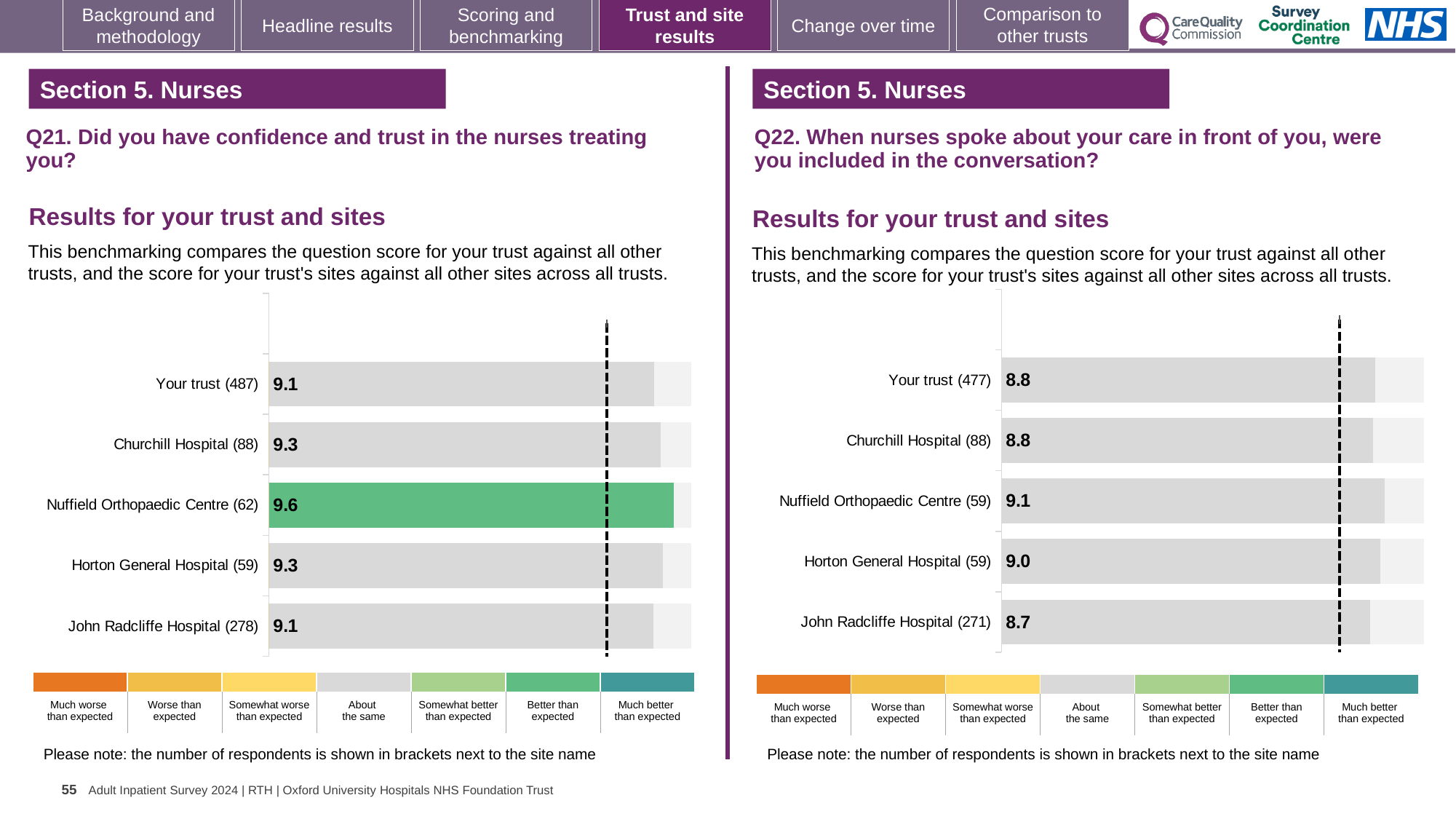
In the Q21 chart (left), which site has the highest score? Nuffield Orthopaedic Centre In the Q22 chart (right), what is the score for Horton General Hospital? 9.0 In the Q22 chart (right), which site has the highest score? Nuffield Orthopaedic Centre In the Q21 chart (left), what is the score for Your trust? 9.1 In the Q22 chart (right), which site has the lowest score? John Radcliffe Hospital How many bars are shown in the Q22 chart (right)? 5 In the Q22 chart (right), what is the difference between the scores for Nuffield Orthopaedic Centre and Your trust? 0.3 In the Q21 chart (left), what is the difference between the scores for Nuffield Orthopaedic Centre and John Radcliffe Hospital? 0.5 In the Q22 chart (right), what is the score for John Radcliffe Hospital? 8.7 In the Q21 chart (left), which has the higher score, Churchill Hospital or Your trust? Churchill Hospital In the Q21 chart (left), what is the score for Nuffield Orthopaedic Centre? 9.6 What type of chart is used for the Q21 results (left)? Bar chart